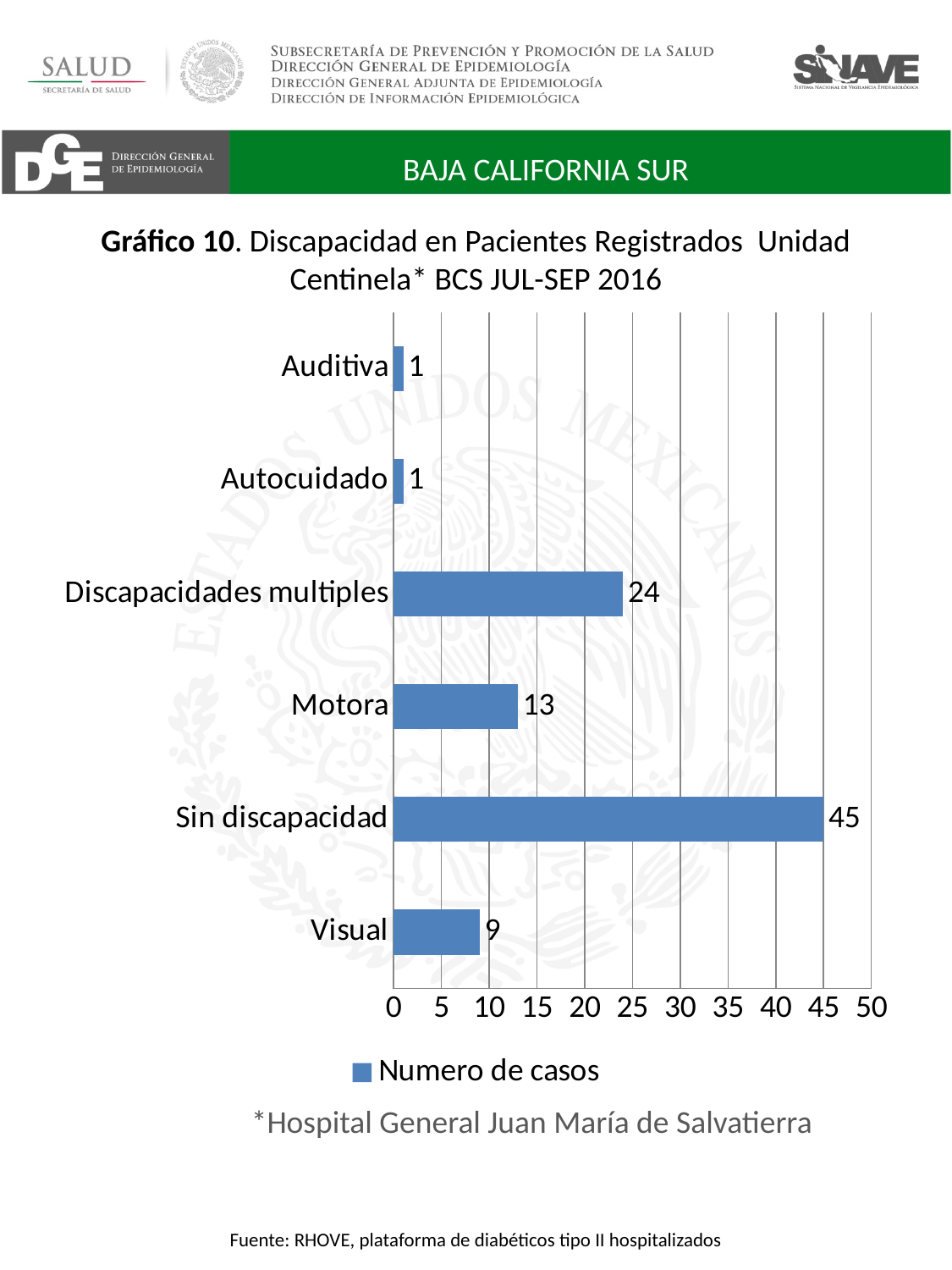
How many series does the legend list? 1 Is the value for Discapacidades multiples greater or less than 20? greater What kind of chart is shown on the slide? Bar chart What is the legend entry for the series in the chart? Numero de casos What is the number of cases for Sin discapacidad? 45 What is the number of cases for Visual? 9 Which has more cases, Motora or Visual? Motora What is the number of cases for Discapacidades multiples? 24 Which category has the highest number of cases? Sin discapacidad How many categories are shown in the chart? 6 What is the difference in number of cases between Sin discapacidad and Discapacidades multiples? 21 What is the number of cases for Motora? 13